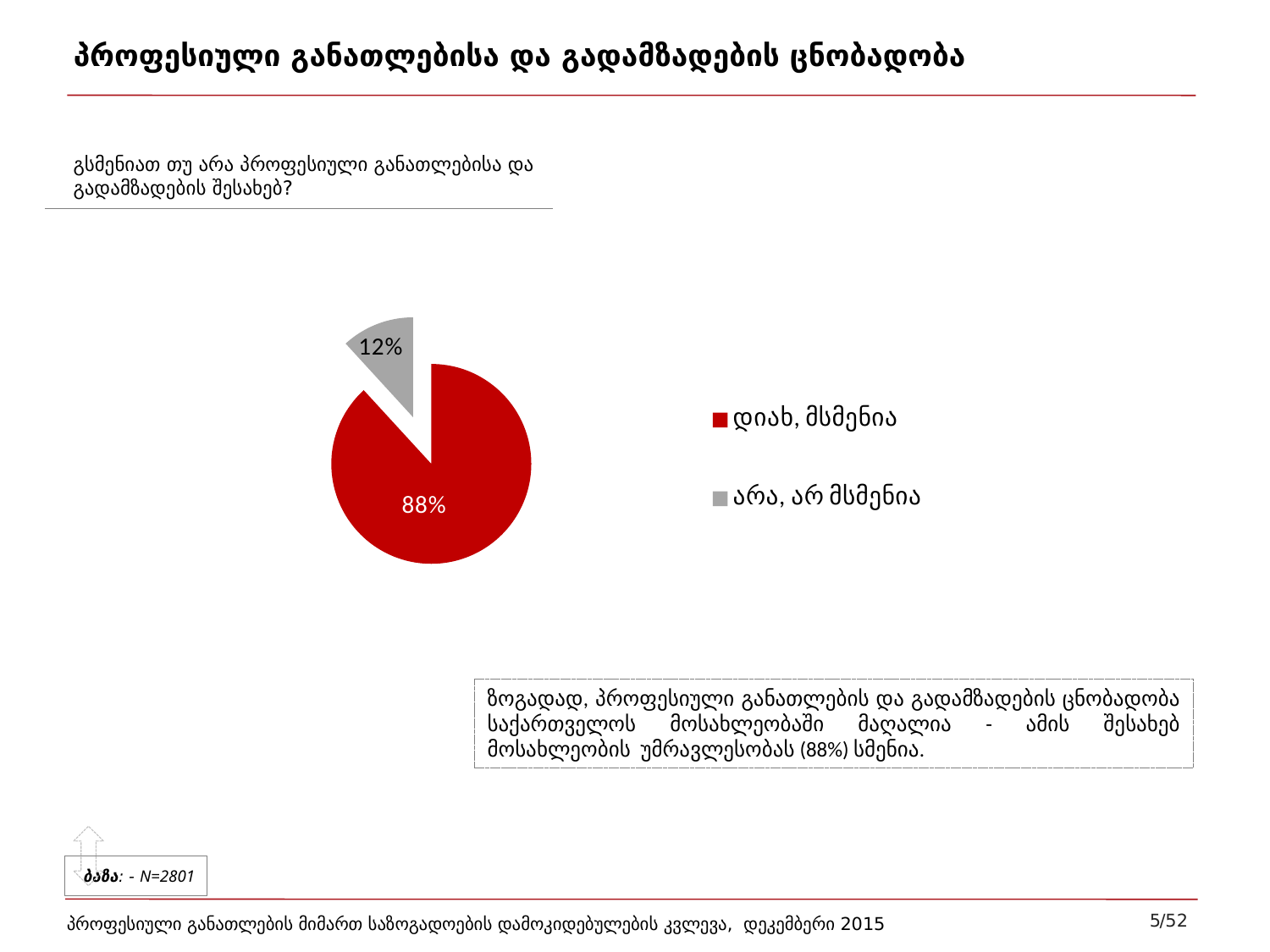
What is the value shown for the grey slice of the pie? 12% What kind of chart is shown on the slide? pie chart How many entries does the legend list? 2 What share of the pie does "დიახ, მსმენია" represent? 88% Which is larger: the share for "დიახ, მსმენია" or the share for "არა, არ მსმენია"? დიახ, მსმენია What is the value shown for the red slice of the pie? 88% Which category has the smallest slice of the pie? არა, არ მსმენია What is the difference in percentage points between "დიახ, მსმენია" and "არა, არ მსმენია"? 76 percentage points How many slices does the pie chart have? 2 What share of the pie does "არა, არ მსმენია" represent? 12% Which category has the largest slice of the pie? დიახ, მსმენია What colour is the slice for "არა, არ მსმენია"? grey